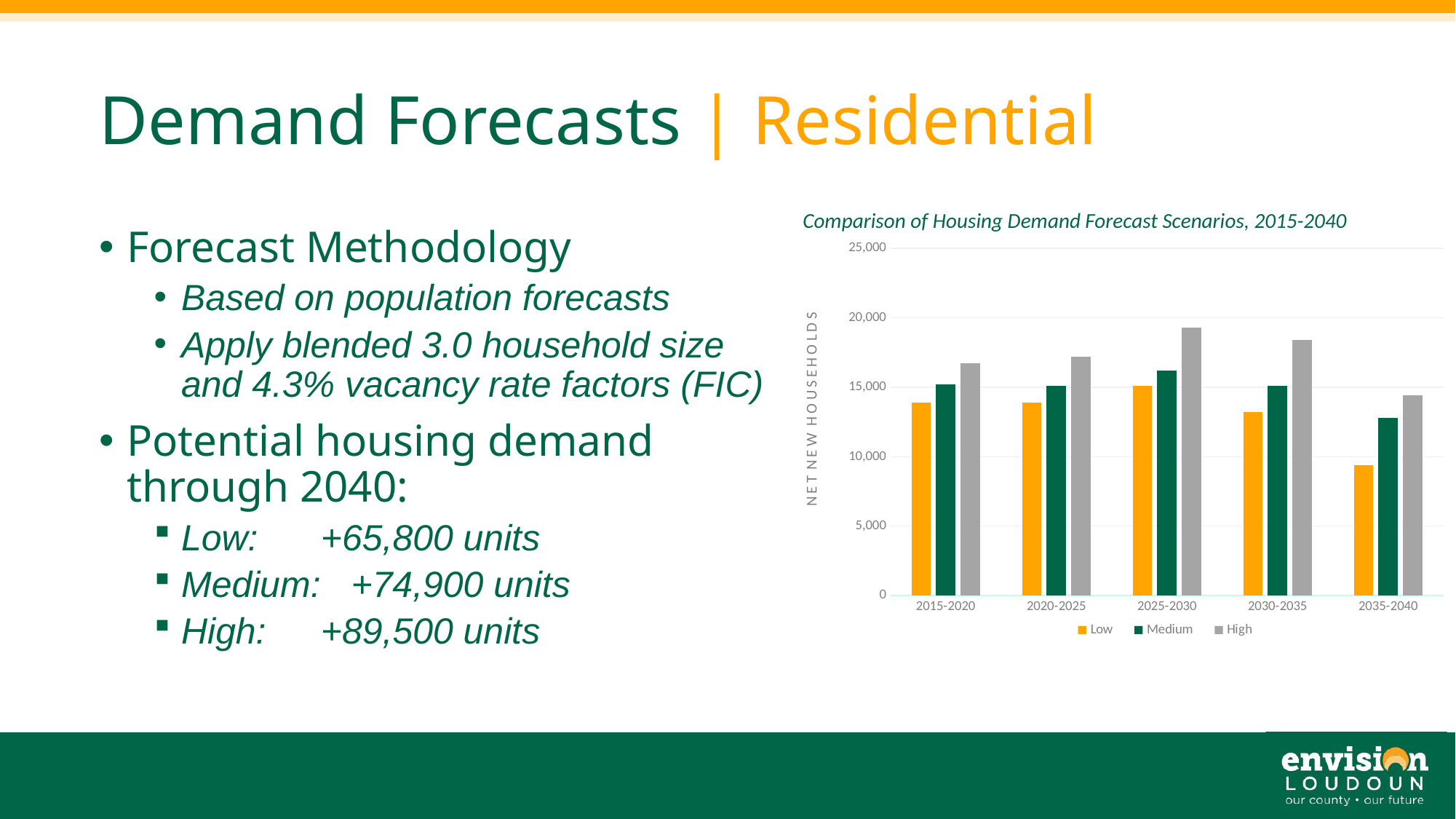
For 2035-2040, which scenario has the larger value, Low or High? High What kind of chart is shown on the slide? bar chart Is the Low scenario value for 2035-2040 greater or less than 10,000? less Does the Low scenario value rise or fall from 2030-2035 to 2035-2040? fall Is the Medium scenario value for 2035-2040 greater or less than 10,000? greater Is the High scenario value for 2025-2030 greater or less than 15,000? greater In which period is the High scenario bar the tallest? 2025-2030 In which period is the Low scenario bar the shortest? 2035-2040 How many time periods are shown along the x axis of the chart? 5 How many series does the chart legend list? 3 What is the label on the vertical axis of the chart? NET NEW HOUSEHOLDS What is the title of the chart? Comparison of Housing Demand Forecast Scenarios, 2015-2040